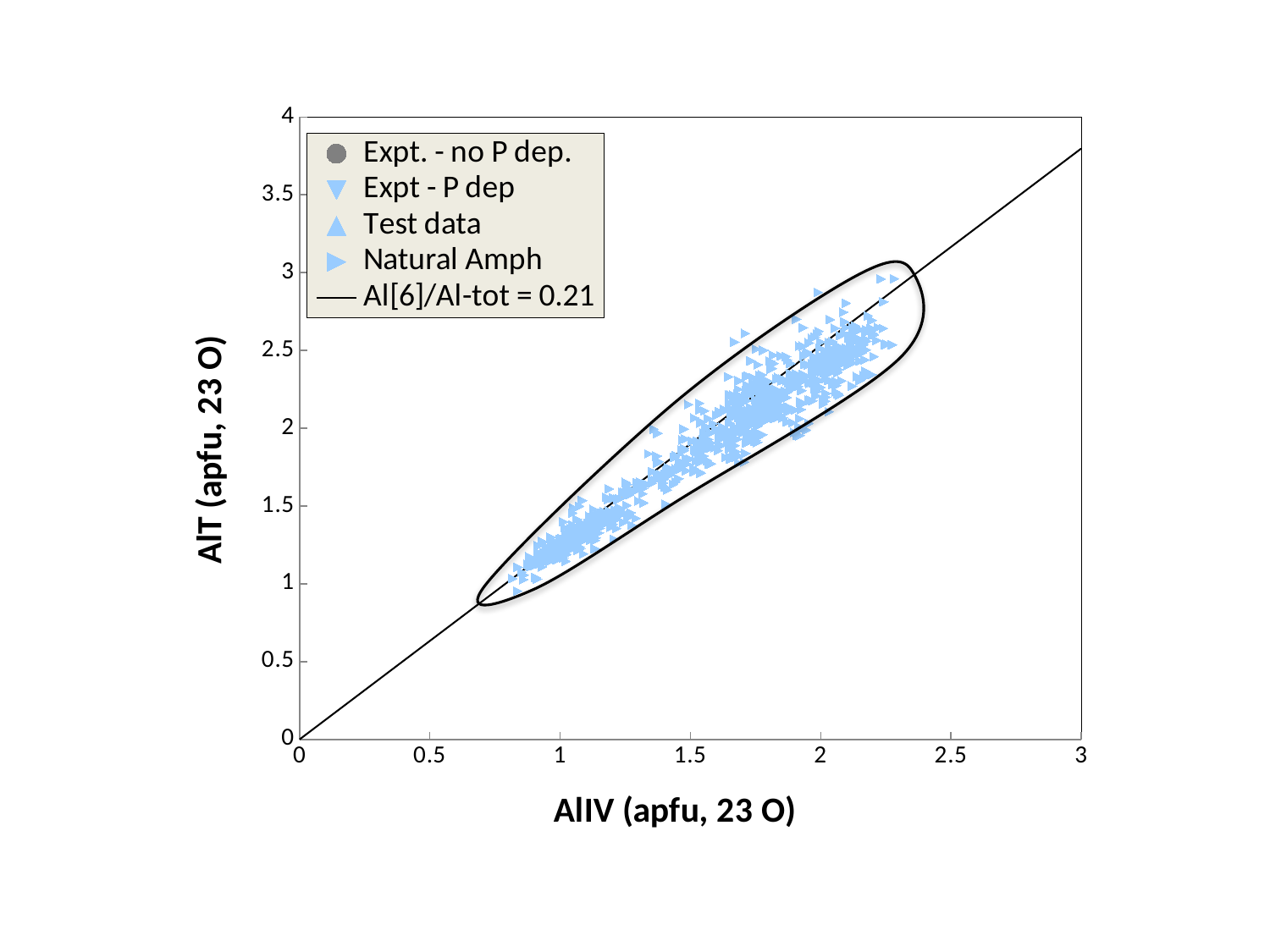
What is the highest value shown on the x axis? 3 What is the title of the y axis? AlT (apfu, 23 O) Is the value of the straight line at AlIV = 3 greater or less than 3.5? greater What is the label of the straight line in the legend? Al[6]/Al-tot = 0.21 What kind of chart is shown on the slide? scatter plot Do the plotted points rise or fall as AlIV increases along the x axis? rise What is the highest value shown on the y axis? 4 How many entries does the legend list? 5